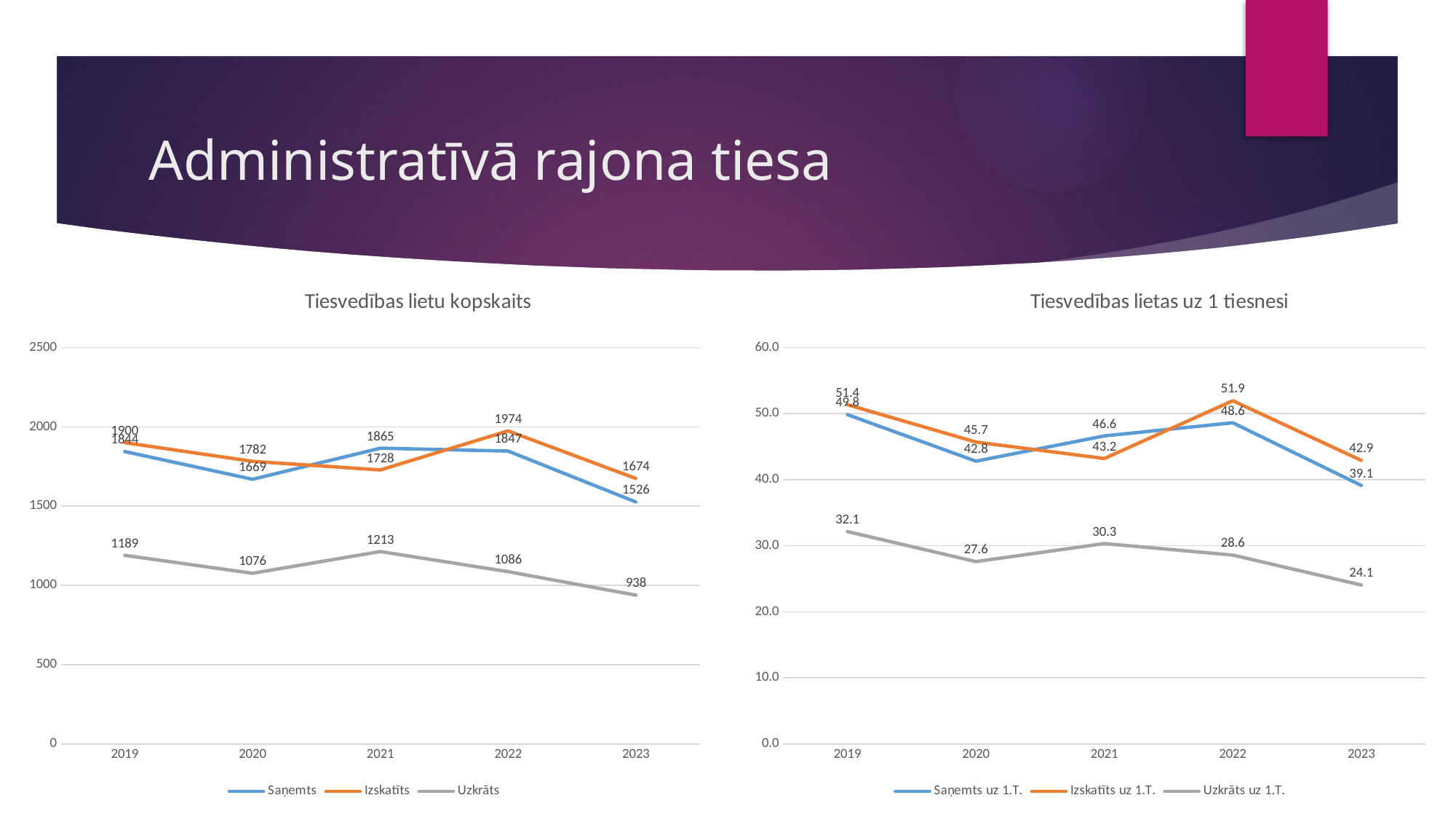
What kind of chart is the chart titled "Tiesvedības lietu kopskaits"? line chart In the chart titled "Tiesvedības lietas uz 1 tiesnesi", in which year is the Saņemts uz 1.T. value highest? 2019 In the chart titled "Tiesvedības lietas uz 1 tiesnesi", does the Uzkrāts uz 1.T. value rise or fall from 2022 to 2023? fall In the chart titled "Tiesvedības lietu kopskaits", in which year is the Saņemts value lowest? 2023 In the chart titled "Tiesvedības lietas uz 1 tiesnesi", what is the value for Izskatīts uz 1.T. in 2022? 51.9 In the chart titled "Tiesvedības lietu kopskaits", in which year is the Uzkrāts value highest? 2021 In the chart titled "Tiesvedības lietu kopskaits", which is larger in 2021: Saņemts or Izskatīts? Saņemts In the chart titled "Tiesvedības lietu kopskaits", what is the value for Uzkrāts in 2023? 938 In the chart titled "Tiesvedības lietu kopskaits", what is the value for Izskatīts in 2022? 1974 In the chart titled "Tiesvedības lietu kopskaits", what is the difference between Izskatīts and Saņemts in 2023? 148 In the chart titled "Tiesvedības lietas uz 1 tiesnesi", what is the value for Uzkrāts uz 1.T. in 2020? 27.6 How many series does the legend of the chart titled "Tiesvedības lietas uz 1 tiesnesi" list? 3